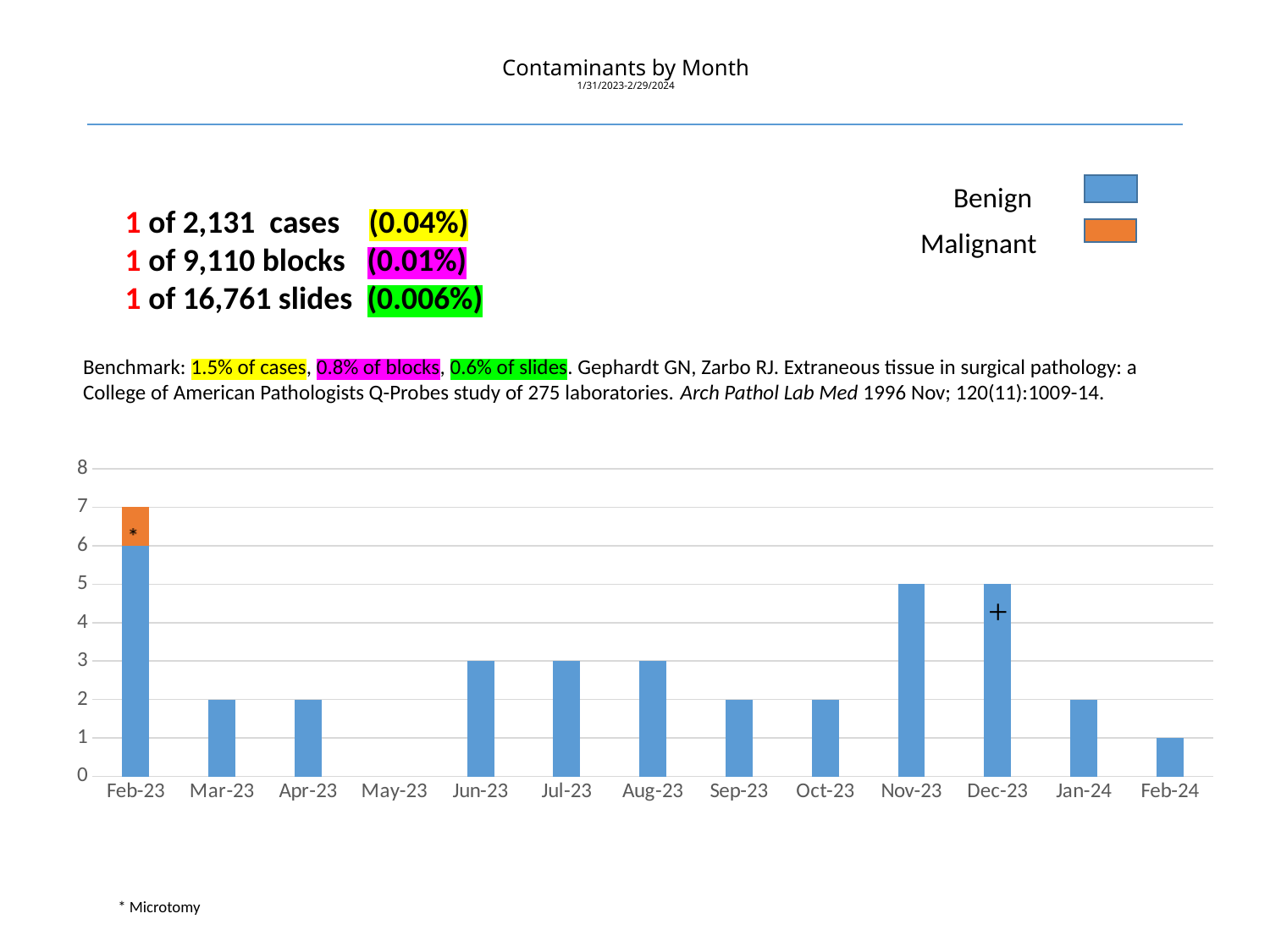
How many series does the legend list? 2 What kind of chart is shown on the slide? bar chart Which month has the tallest bar? Feb-23 Is the value for Dec-23 greater or less than 4? greater What is the value of the bar for Feb-24? 1 What is the total height of the stacked bar for Feb-23? 7 What is the title of the chart? Contaminants by Month How many months are shown on the x axis of the chart? 13 What is the Benign value for Feb-23? 6 Which is larger, the value for Jul-23 or the value for Sep-23? Jul-23 What is the difference between the values for Nov-23 and Jun-23? 2 What is the value of the bar for Nov-23? 5